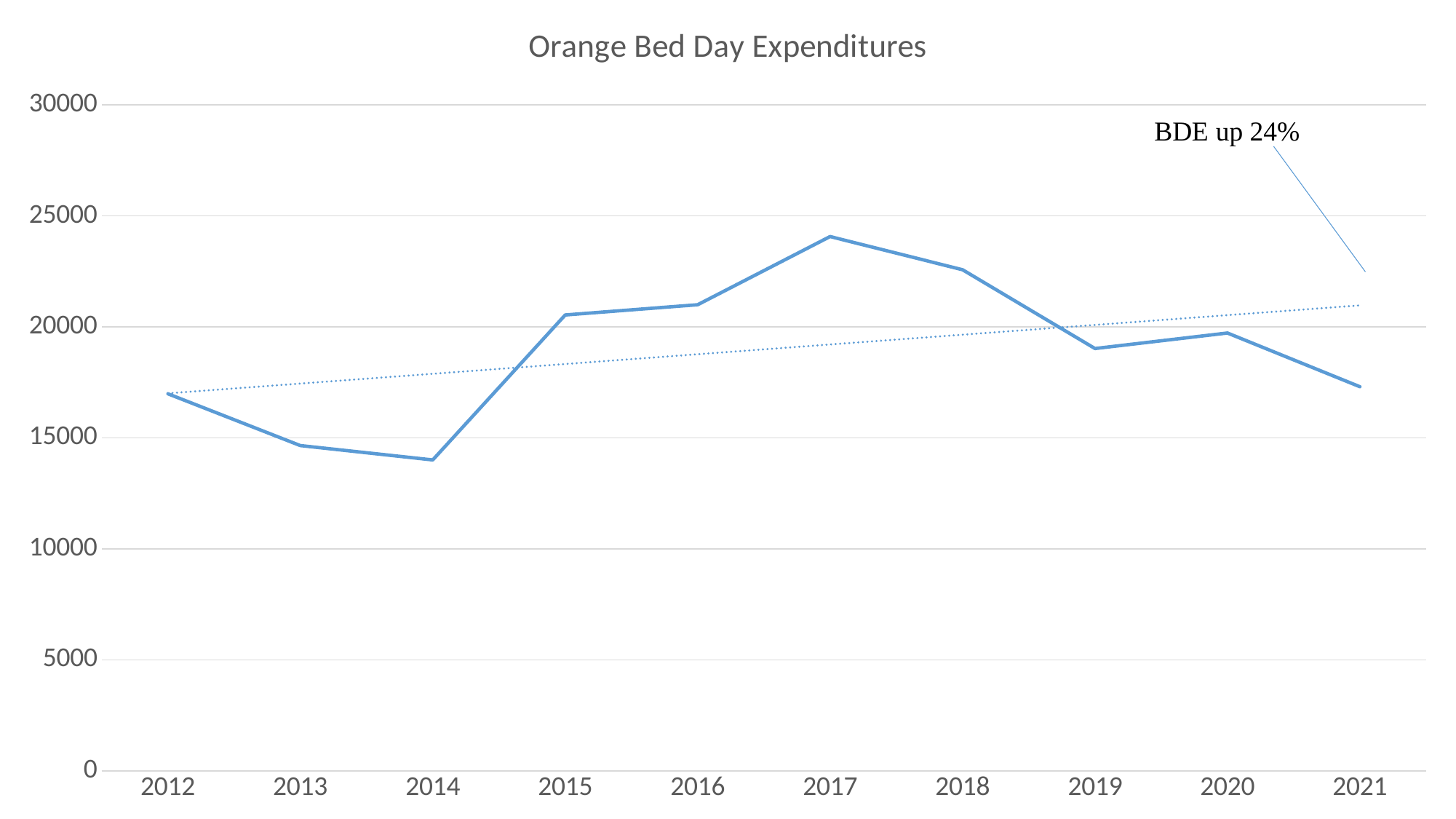
Is the value for 2014 greater or less than 15000? less Does the expenditure rise or fall from 2017 to 2019? fall How many years are plotted along the x axis? 10 In which year is the expenditure lowest? 2014 In which year is the expenditure highest? 2017 Is the value for 2015 greater or less than 20000? greater Is the value for 2019 greater or less than 20000? less What does the text annotation on the chart say? BDE up 24% What is the title of the chart? Orange Bed Day Expenditures Which year has the higher expenditure, 2018 or 2021? 2018 What type of chart is shown on the slide? line chart